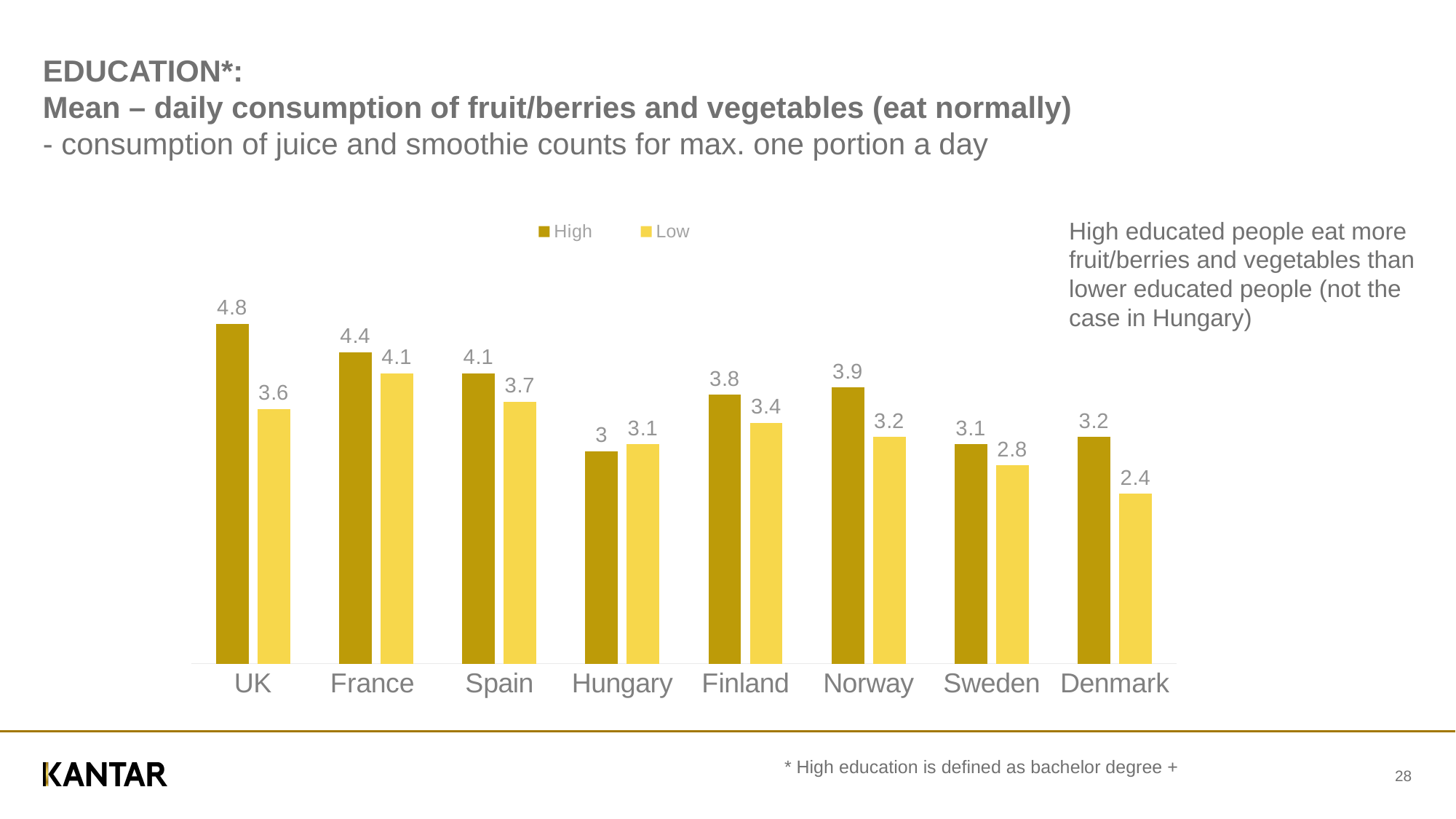
Which country has the highest value in the High series? UK What is the difference between the High and Low values for the UK? 1.2 What is the value for the High series for the UK? 4.8 Which is larger, the High value for Norway or the High value for Finland? Norway What is the value for the Low series for Hungary? 3.1 How many countries are shown on the x axis? 8 What kind of chart is shown on the slide? Bar chart Which country has the lowest value in the Low series? Denmark Which is larger for Hungary, the High value or the Low value? Low What is the value for the Low series for Denmark? 2.4 What is the difference between the High values for France and Sweden? 1.3 How many series does the legend list? 2